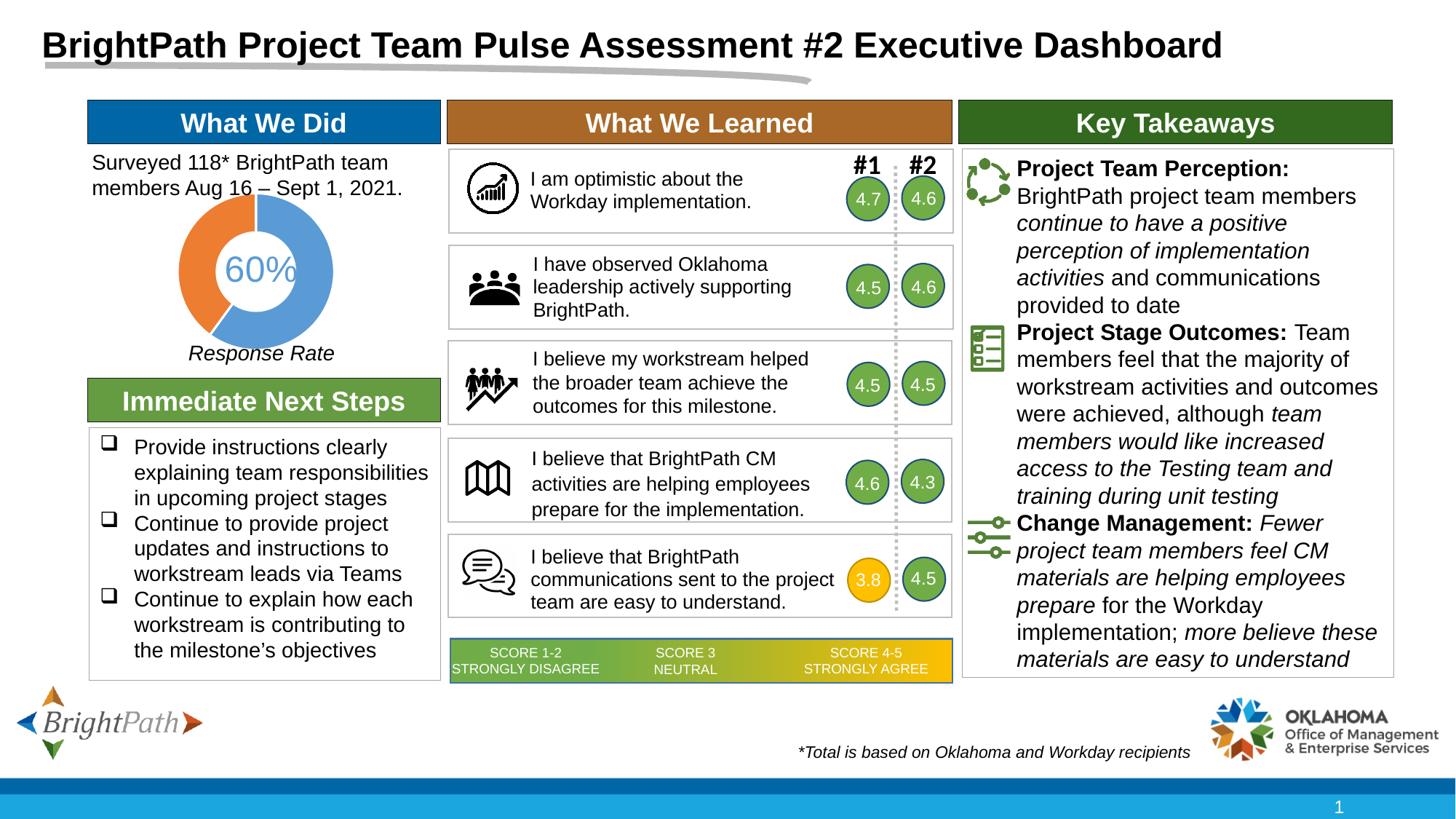
What colour is the larger slice of the donut chart? blue Does the blue slice of the donut chart cover more or less than half of the ring? more What value is printed in the center of the donut chart? 60% What kind of chart is shown in the "What We Did" section? donut chart What share of the donut chart does the blue slice represent? 60% What does the donut chart represent, according to its caption? Response Rate Which slice of the donut chart is larger, the blue one or the orange one? blue How many slices does the donut chart have? 2